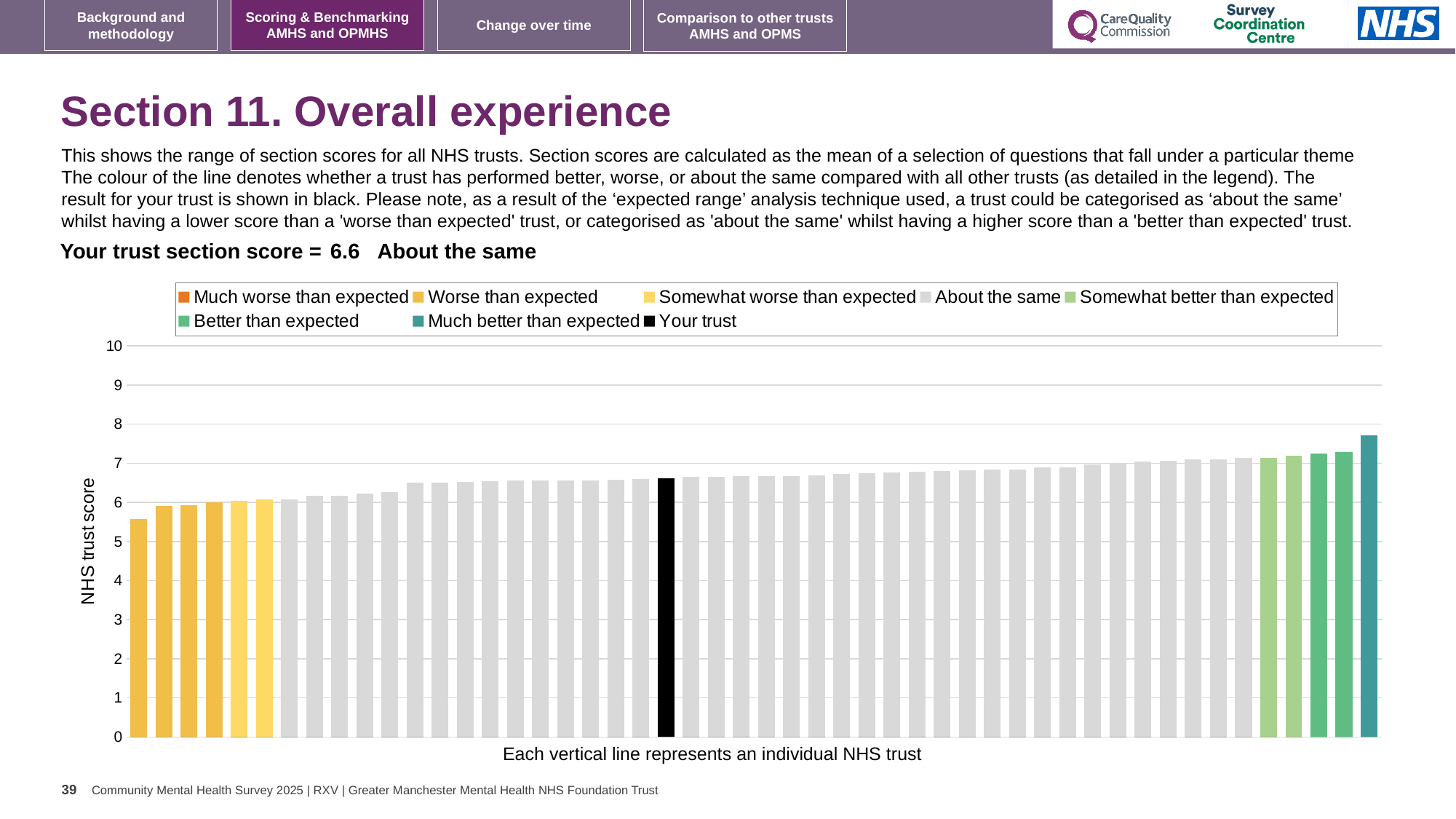
What kind of chart is shown on the slide? bar chart What is your trust's section score for Section 11, Overall experience? 6.6 Is the value of the rightmost (highest) bar greater or less than 8? less What is the title of the vertical axis? NHS trust score Is the value of the leftmost (lowest) bar greater or less than 6? less What colour is used for the bar representing your trust? black Is the value of the rightmost (highest) bar greater or less than 7? greater How many entries does the chart legend list? 8 Which category is your trust placed in for Section 11, Overall experience? About the same Do the bar values rise or fall from left to right along the x axis? rise